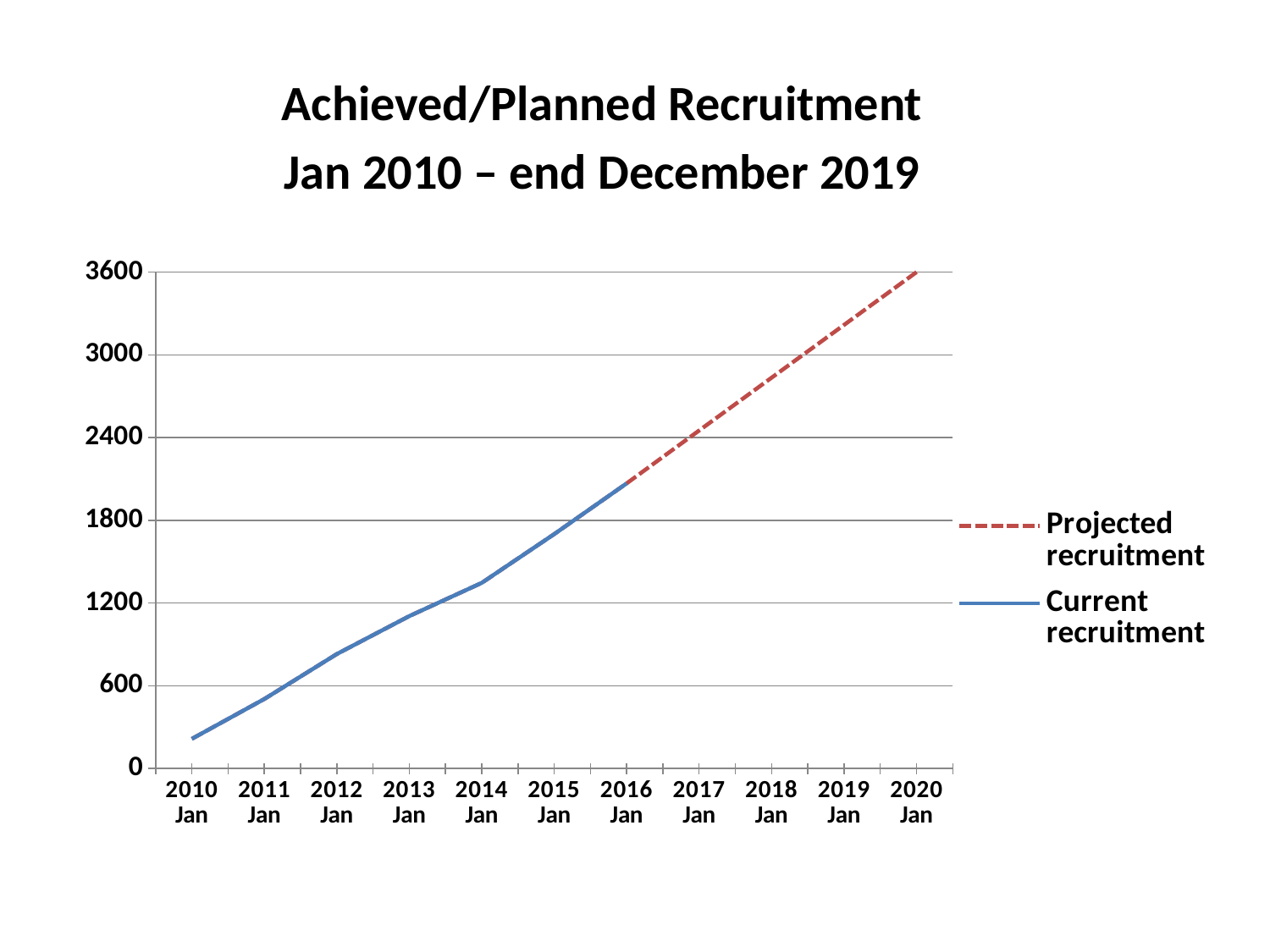
Does recruitment rise or fall from 2010 Jan to 2020 Jan? rise What kind of chart is shown on the slide? line chart At which x-axis point is the line at its lowest value? 2010 Jan How many series does the legend list? 2 Which series is drawn with a dashed line? Projected recruitment Is the current recruitment value at 2016 Jan greater or less than 1800? greater What are the two series named in the legend? Projected recruitment and Current recruitment Is the current recruitment value at 2010 Jan greater or less than 600? less At which x-axis point does the line reach its highest value? 2020 Jan Which is larger, the current recruitment at 2015 Jan or at 2013 Jan? 2015 Jan Is the projected recruitment value at 2019 Jan greater or less than 3000? greater How many points are labelled along the x axis? 11